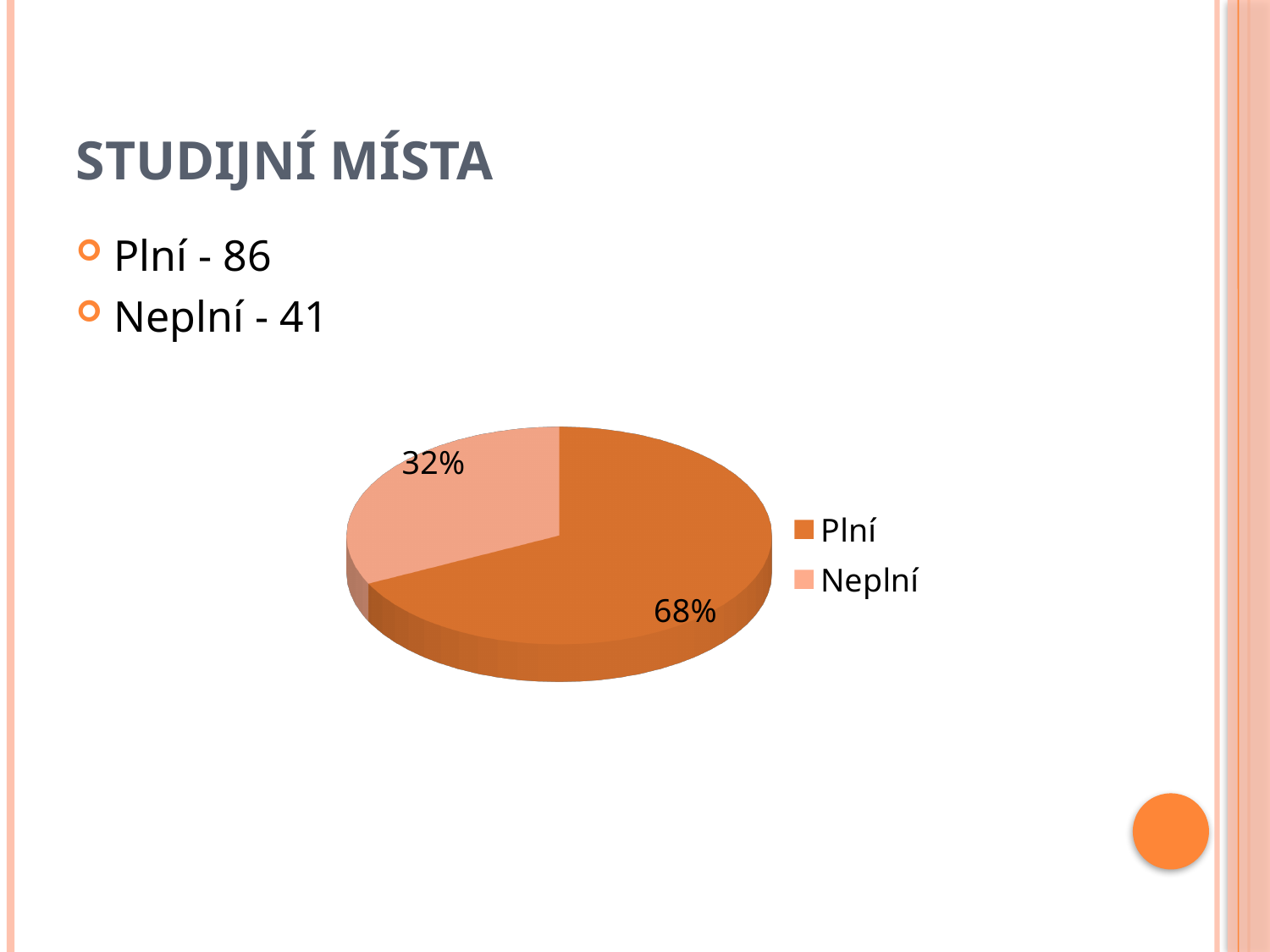
Which legend entry is shown in the lighter orange colour? Neplní What is the title of the slide containing the pie chart? STUDIJNÍ MÍSTA Which slice of the pie is the smallest? Neplní How many slices does the pie chart have? 2 What share of the pie does the Neplní slice represent? 32% Which is larger, the Plní slice or the Neplní slice? Plní What is the difference in percentage points between the Plní and Neplní slices? 36 Which slice of the pie is the largest? Plní What share of the pie does the Plní slice represent? 68% How many entries does the legend list? 2 What kind of chart is shown on the slide? pie chart